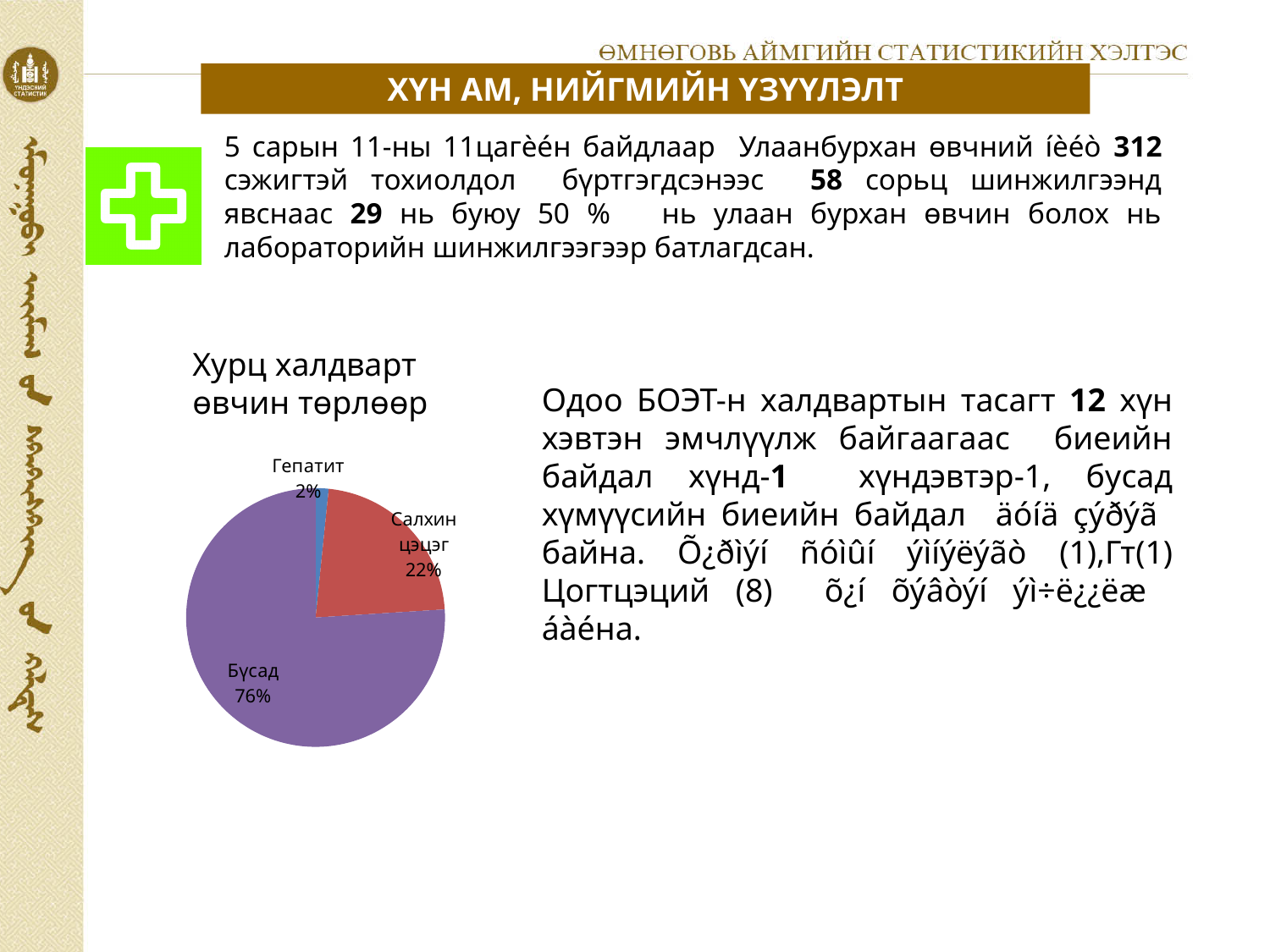
What share of the pie does Салхин цэцэг represent? 22% What is the title of the chart on the slide? Хурц халдварт өвчин төрлөөр What type of chart is shown on the slide? pie chart What colour is the Бусад slice in the pie chart? purple Which is larger, the share for Салхин цэцэг or the share for Гепатит? Салхин цэцэг What is the difference in percentage points between Салхин цэцэг and Гепатит? 20 Which category has the smallest slice in the pie chart? Гепатит What is the difference in percentage points between Бусад and Салхин цэцэг? 54 How many slices does the pie chart have? 3 What share of the pie does Бусад represent? 76% What share of the pie does Гепатит represent? 2% Which category has the largest slice in the pie chart? Бусад